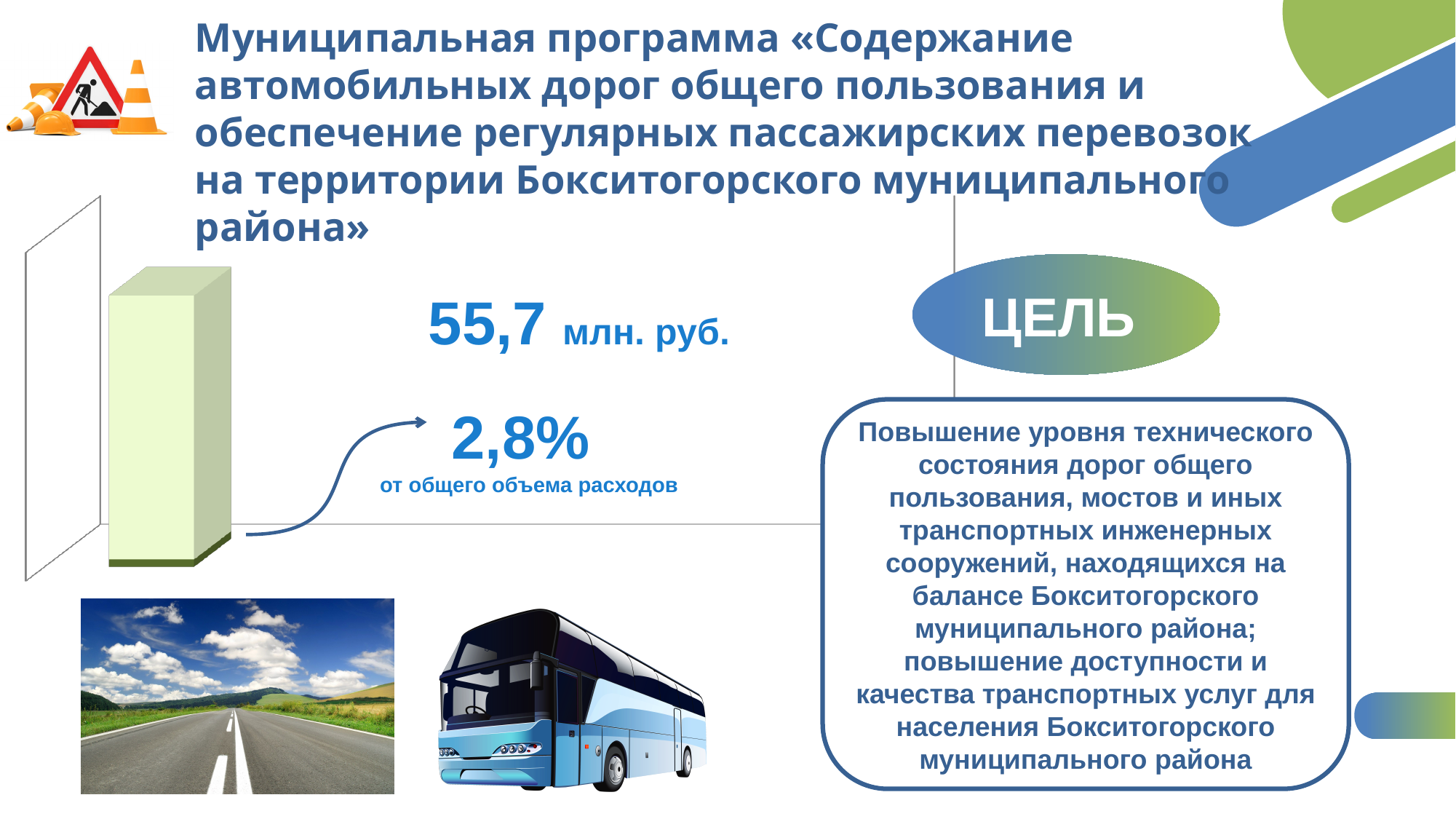
What colour is the bar in the chart on the slide? light green What percentage of total expenditure does the bar on the slide represent? 2,8% What kind of chart is shown on the left of the slide? bar chart How many bars are plotted in the chart on the slide? 1 What value in million rubles is shown next to the bar on the slide? 55,7 млн. руб. What does the label under the 2,8% figure say the percentage is of? от общего объема расходов